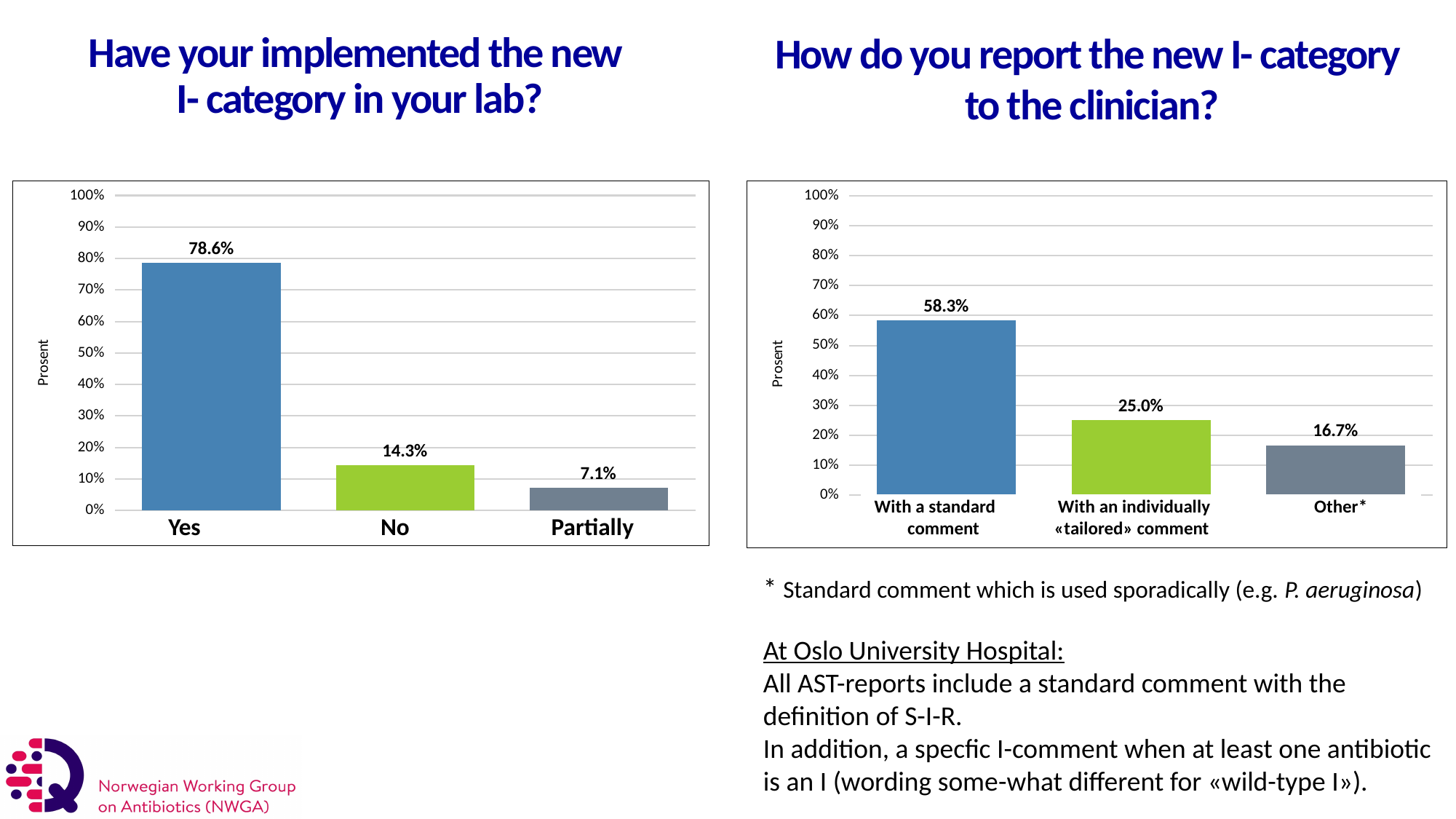
In the right chart (How do you report the new I- category to the clinician?), what is the value for Other*? 16.7% In the left chart (Have your implemented the new I- category in your lab?), what is the value for Partially? 7.1% In the right chart (How do you report the new I- category to the clinician?), what is the value for With a standard comment? 58.3% In the right chart (How do you report the new I- category to the clinician?), what is the difference between With a standard comment and With an individually «tailored» comment? 33.3% In the left chart (Have your implemented the new I- category in your lab?), how many categories are shown? 3 In the left chart (Have your implemented the new I- category in your lab?), what is the y-axis label? Prosent In the left chart (Have your implemented the new I- category in your lab?), what is the difference between the values for Yes and No? 64.3% What type of chart is the right chart (How do you report the new I- category to the clinician?)? Bar chart In the left chart (Have your implemented the new I- category in your lab?), what is the value for Yes? 78.6% In the right chart (How do you report the new I- category to the clinician?), which is larger: With an individually «tailored» comment or Other*? With an individually «tailored» comment In the right chart (How do you report the new I- category to the clinician?), which category has the highest value? With a standard comment In the left chart (Have your implemented the new I- category in your lab?), which category has the lowest value? Partially